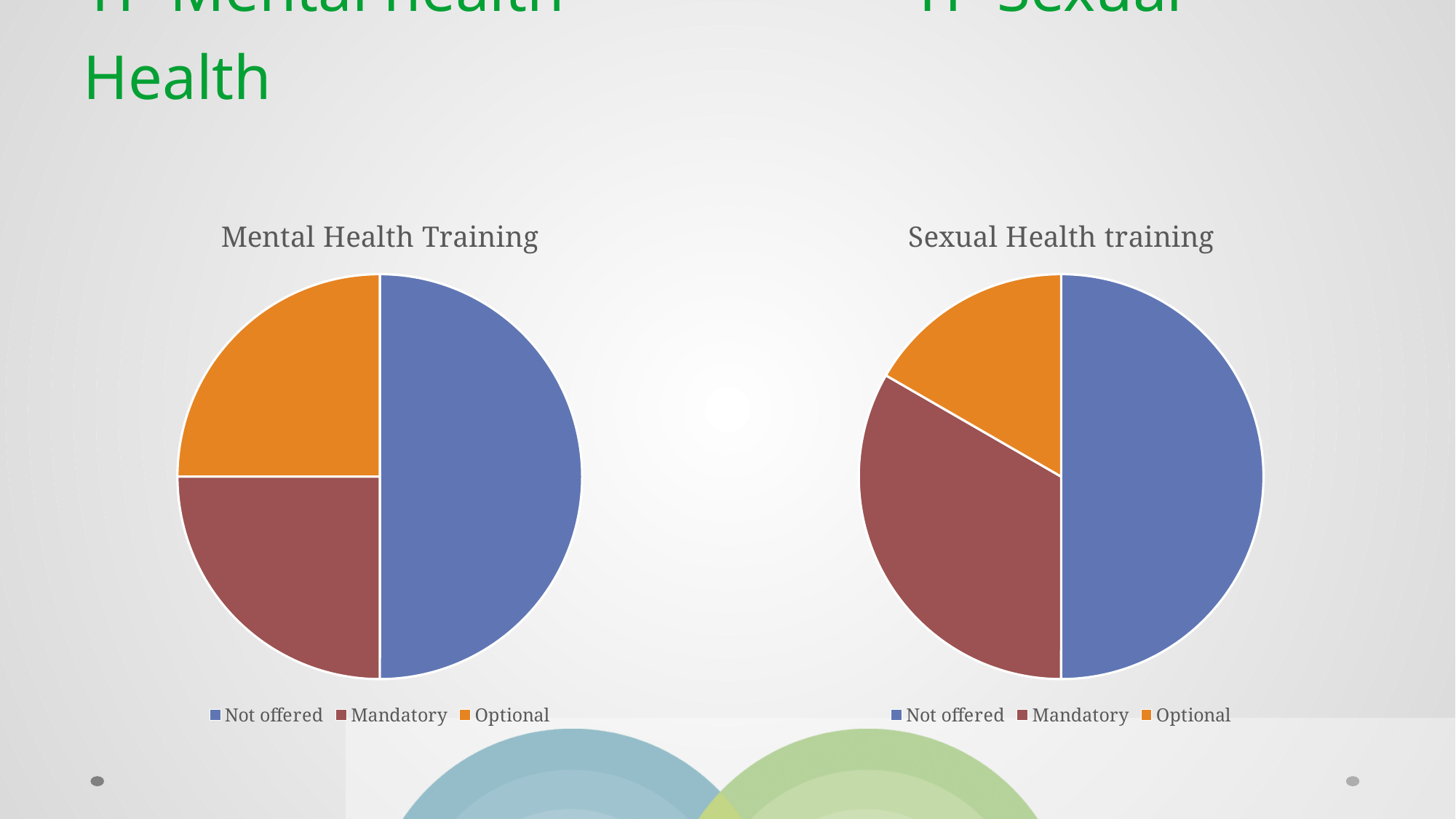
What kind of chart is the Mental Health Training chart? pie chart What kind of chart is the Sexual Health training chart? pie chart How many slices does the Mental Health Training pie chart have? 3 In the Sexual Health training chart, which is larger: Mandatory or Optional? Mandatory In the Sexual Health training chart, which colour represents Mandatory? red In the Sexual Health training chart, which category has the largest slice? Not offered How many entries does the legend of the Sexual Health training chart list? 3 In the Sexual Health training chart, which is larger: Not offered or Optional? Not offered In the Sexual Health training chart, which category has the smallest slice? Optional What is the title of the pie chart on the left of the slide? Mental Health Training In the Mental Health Training chart, which category has the largest slice? Not offered In the Mental Health Training chart, which is larger: Not offered or Mandatory? Not offered